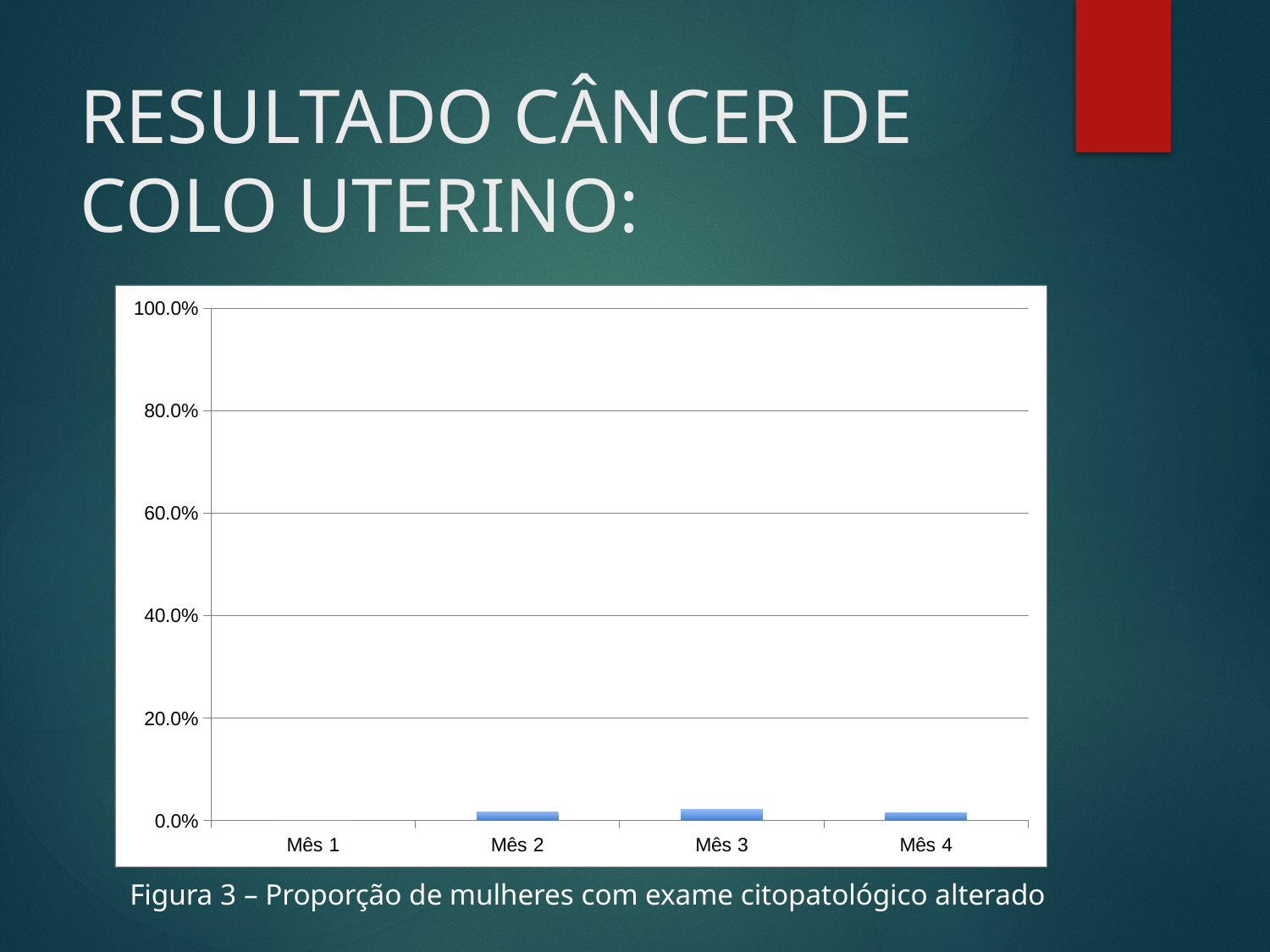
How many categories are shown on the x axis of the chart? 4 Is the value for Mês 4 greater or less than 40.0%? less Which is larger, the value for Mês 1 or the value for Mês 3? Mês 3 Is the value for Mês 3 greater or less than 20.0%? less What is the label of the first category on the x axis? Mês 1 What kind of chart is shown on the slide? bar chart Which is larger, the value for Mês 2 or the value for Mês 1? Mês 2 What is the caption given below the chart? Figura 3 – Proporção de mulheres com exame citopatológico alterado Is the value for Mês 2 greater or less than 20.0%? less Which category has the lowest value in the chart? Mês 1 What is the highest value shown on the y axis of the chart? 100.0%